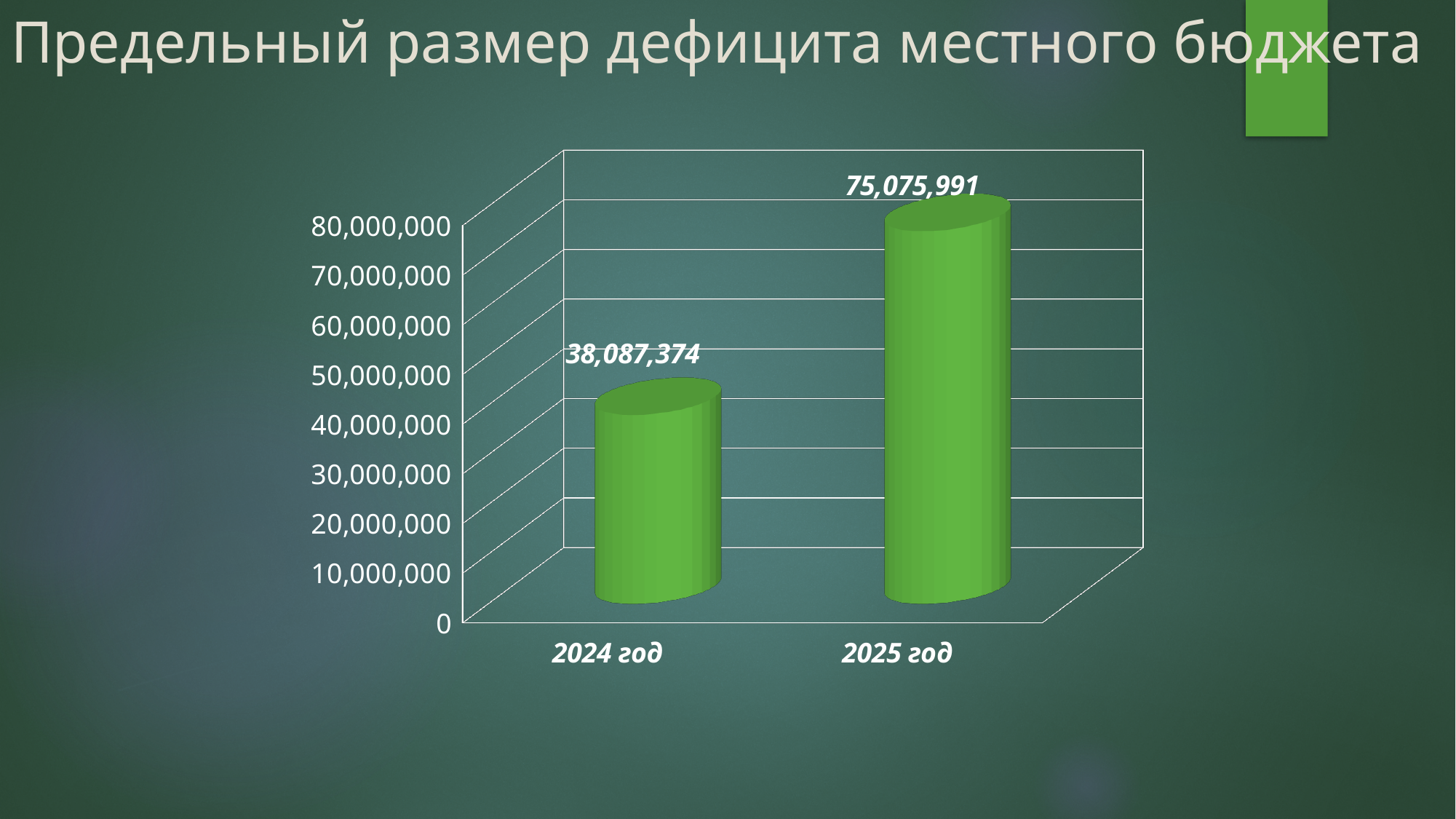
Which year has the lowest value? 2024 год What is the value for 2024 год? 38,087,374 What is the value for 2025 год? 75,075,991 Is the value for 2025 год greater or less than 70,000,000? greater Is the value for 2024 год greater or less than 40,000,000? less Which is larger, the value for 2024 год or the value for 2025 год? 2025 год Do the values rise or fall from 2024 год to 2025 год? rise How many categories are shown on the x axis? 2 What is the difference between the values for 2025 год and 2024 год? 36,988,617 What is the title of the slide? Предельный размер дефицита местного бюджета What kind of chart is shown on the slide? bar chart Which year has the highest value? 2025 год